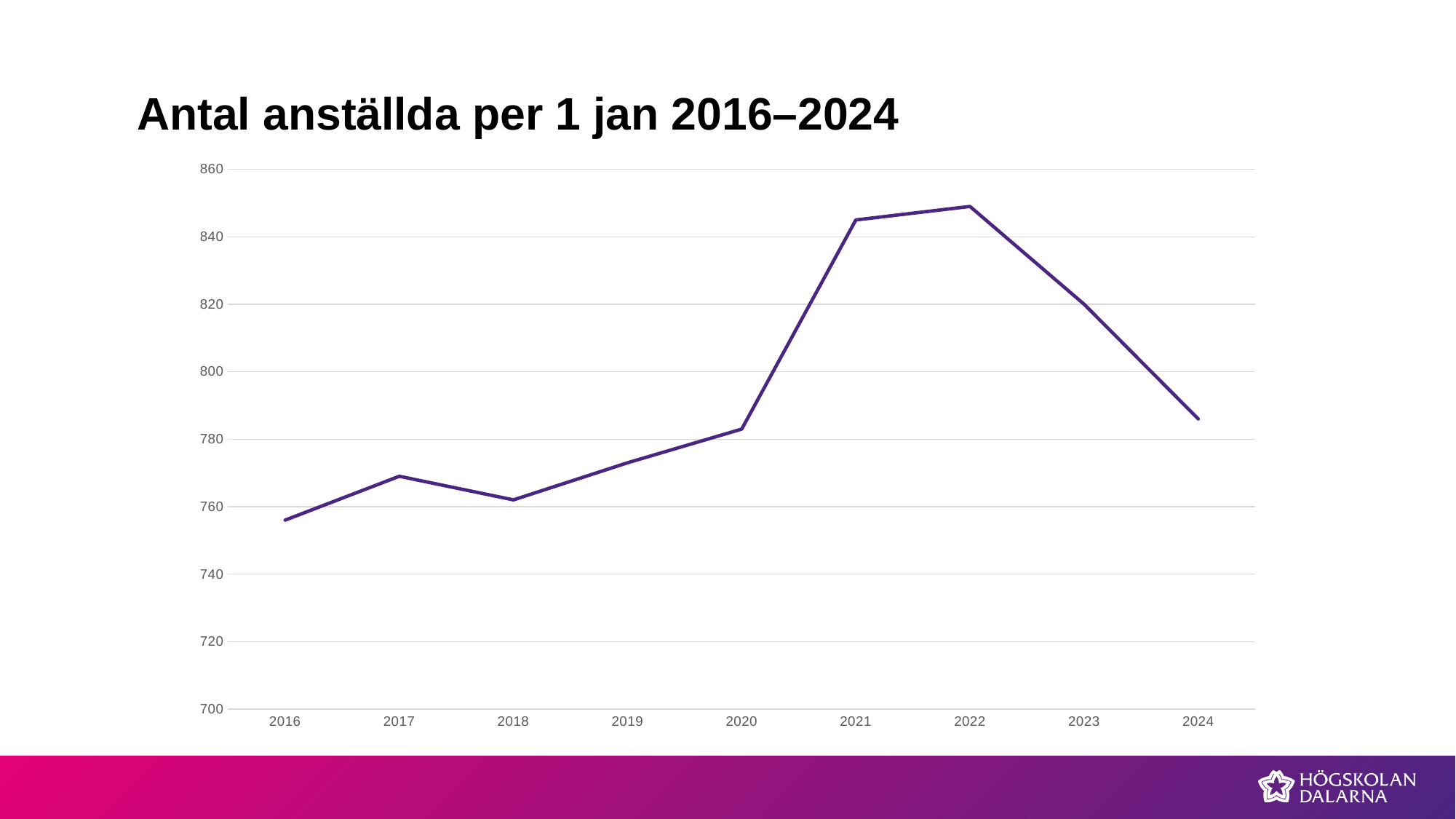
How many years are plotted on the x axis? 9 Is the value for 2016 greater or less than 760? less Do the values rise or fall from 2022 to 2024? fall What is the title of the chart? Antal anställda per 1 jan 2016–2024 Which year has the highest number of employees? 2022 Which year has the lowest number of employees? 2016 Is the value for 2023 greater or less than 800? greater Is the value for 2021 greater or less than 840? greater Which year has the larger value, 2023 or 2024? 2023 What kind of chart is shown on the slide? line chart Which year has the larger value, 2017 or 2018? 2017